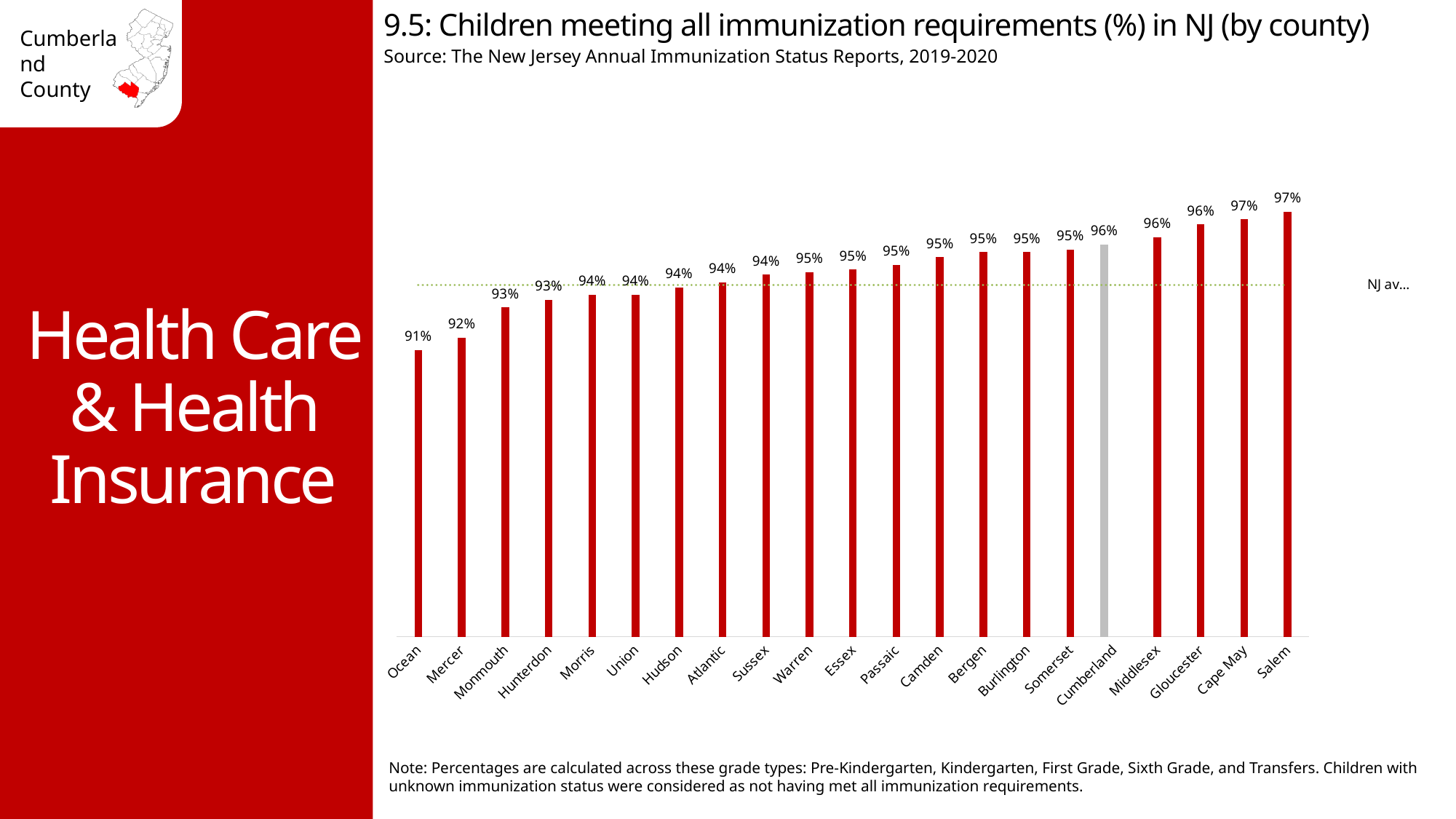
What percentage is shown for Hunterdon County? 93% What percentage of children in Cumberland County met all immunization requirements? 96% What type of chart is used on this slide? Bar chart What is the value shown for Ocean County? 91% Which county has the lowest percentage of children meeting all immunization requirements? Ocean What is the difference between Cumberland County's value and Mercer County's value? 4 percentage points Which county's bar is coloured grey instead of red? Cumberland What is the value for Cape May County? 97% How many counties are shown on the chart? 21 What is the highest percentage value shown on the chart? 97% What is the difference in percentage points between Salem County and Ocean County? 6 percentage points Which has a higher value, Cumberland County or Monmouth County? Cumberland